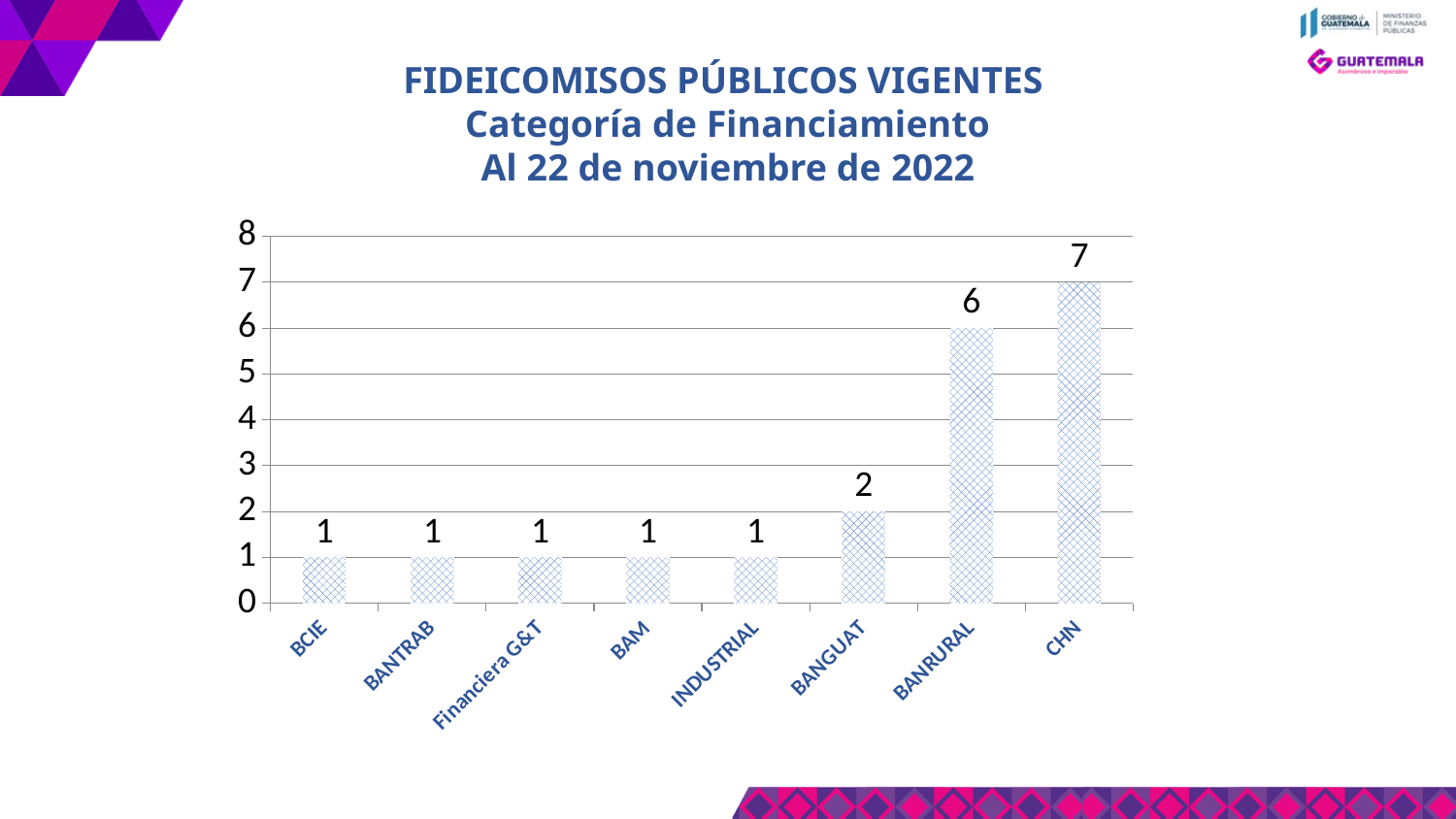
How many categories are shown on the x axis? 8 Is the value for BANRURAL greater or less than 4? greater What is the value for Financiera G&T? 1 What is the value for BANRURAL? 6 What is the value for CHN? 7 What is the difference between the values for CHN and BANRURAL? 1 What is the value for BANGUAT? 2 Which category has the highest value? CHN Which is larger, the value for BANGUAT or the value for BAM? BANGUAT What is the difference between the values for BANRURAL and BANGUAT? 4 What is the first line of the chart title? FIDEICOMISOS PÚBLICOS VIGENTES What kind of chart is shown on the slide? bar chart